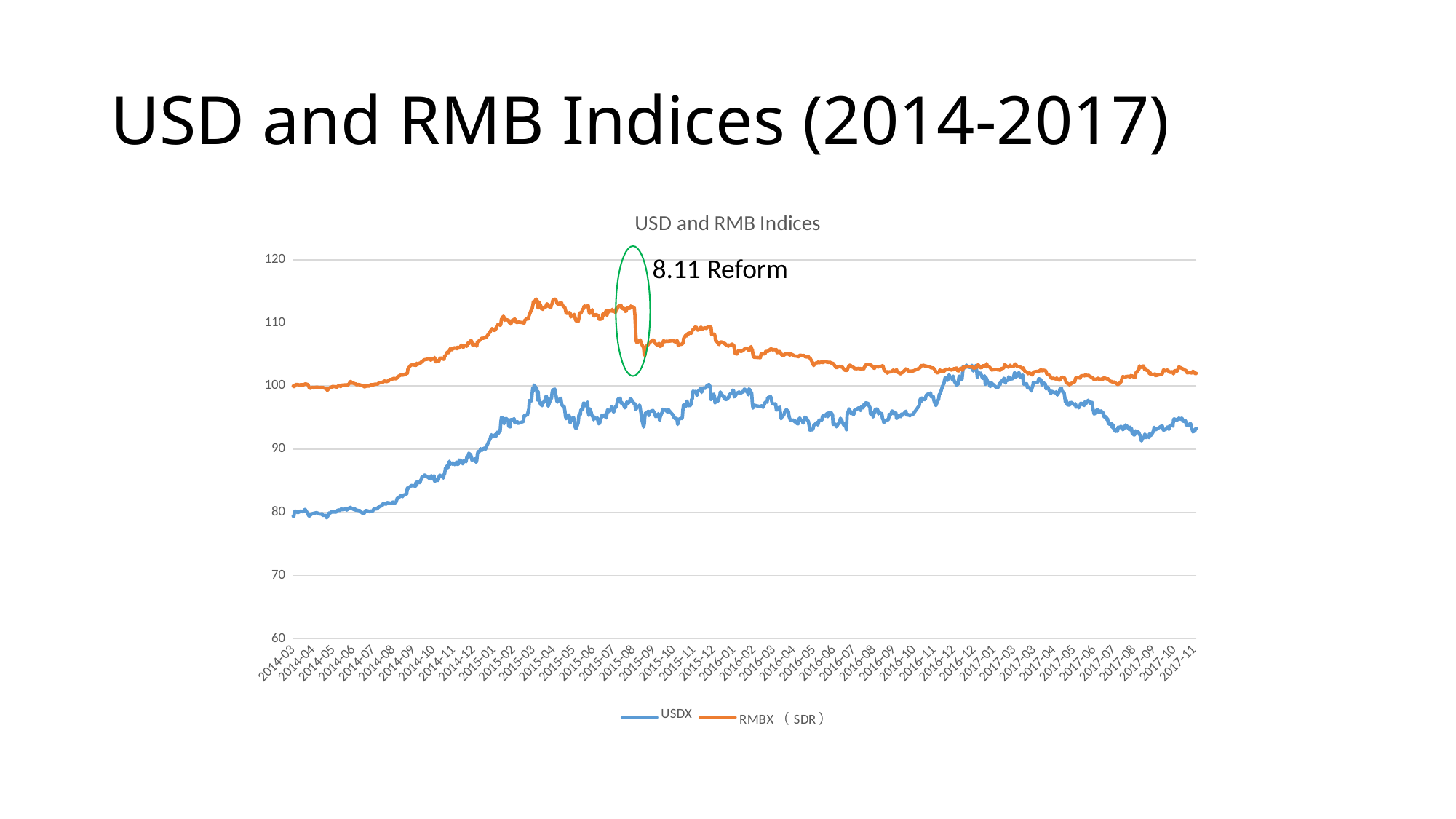
How many series does the legend list? 2 At 2015-03, which series has the higher value, USDX or RMBX (SDR)? RMBX (SDR) What kind of chart is shown on the slide? line chart Is the USDX value at 2017-11 greater or less than 100? less Is the USDX value at 2014-03 greater or less than 90? less What is the title printed above the chart? USD and RMB Indices At 2014-03, which series has the higher value, USDX or RMBX (SDR)? RMBX (SDR) Does the RMBX (SDR) series rise or fall overall from 2015-04 to 2017-11? fall Is the RMBX (SDR) value at 2017-11 greater or less than 100? greater What annotation is written next to the green circle on the chart? 8.11 Reform Does the USDX series rise or fall from 2014-03 to 2015-03? rise